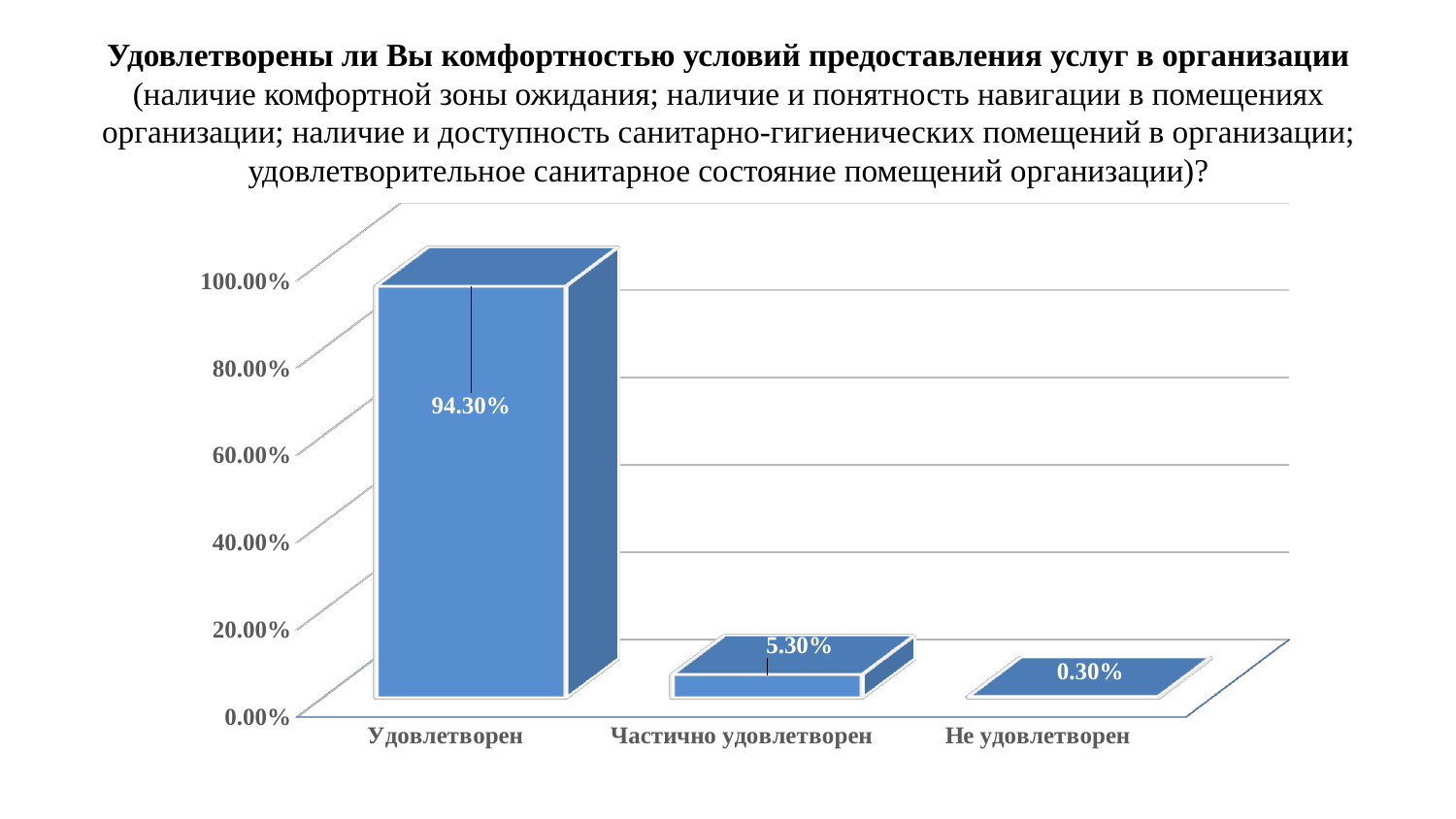
Is the value for "Частично удовлетворен" greater or less than 20.00%? less What is the value for "Удовлетворен"? 94.30% Which category has the highest value? Удовлетворен What is the difference between the values for "Удовлетворен" and "Частично удовлетворен"? 89.00% What is the difference between the values for "Частично удовлетворен" and "Не удовлетворен"? 5.00% Is the value for "Удовлетворен" greater or less than 80.00%? greater Which is larger, the value for "Частично удовлетворен" or the value for "Не удовлетворен"? Частично удовлетворен What is the value for "Частично удовлетворен"? 5.30% Which category has the lowest value? Не удовлетворен What kind of chart is shown on the slide? bar chart How many categories are shown on the x axis? 3 What is the value for "Не удовлетворен"? 0.30%